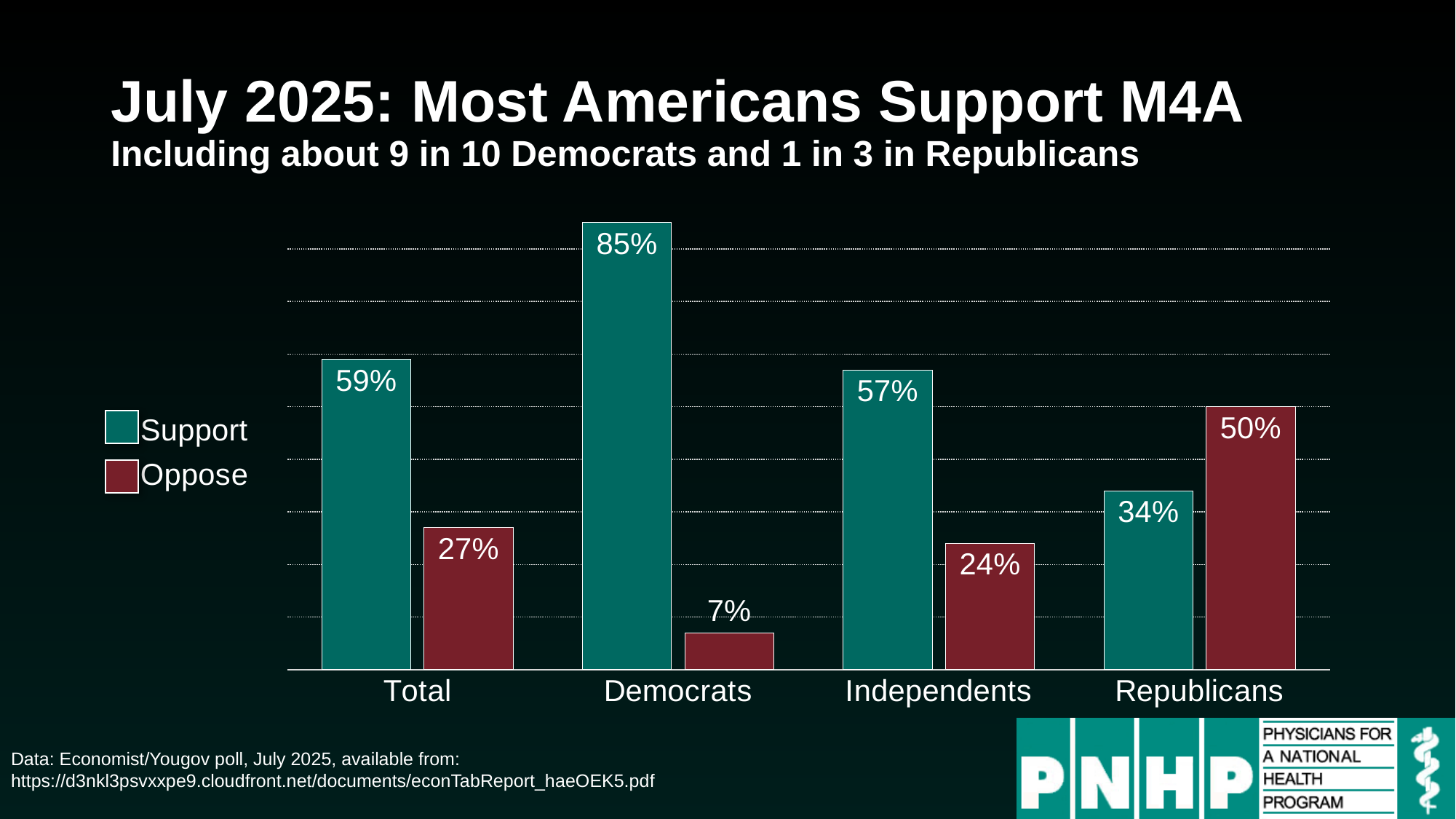
What is the difference between Support and Oppose for Republicans? 16% Which is larger for Republicans, Support or Oppose? Oppose What percentage of Republicans oppose M4A? 50% What is the Oppose value for the Total category? 27% How many series does the legend list? 2 What kind of chart is shown on the slide? Bar chart What percentage of Democrats support M4A? 85% Which category has the highest Support value? Democrats Which category has the lowest Oppose value? Democrats What is the Support value for Independents? 57% How many categories are shown on the x axis? 4 What is the difference between the Support values for Democrats and Independents? 28%